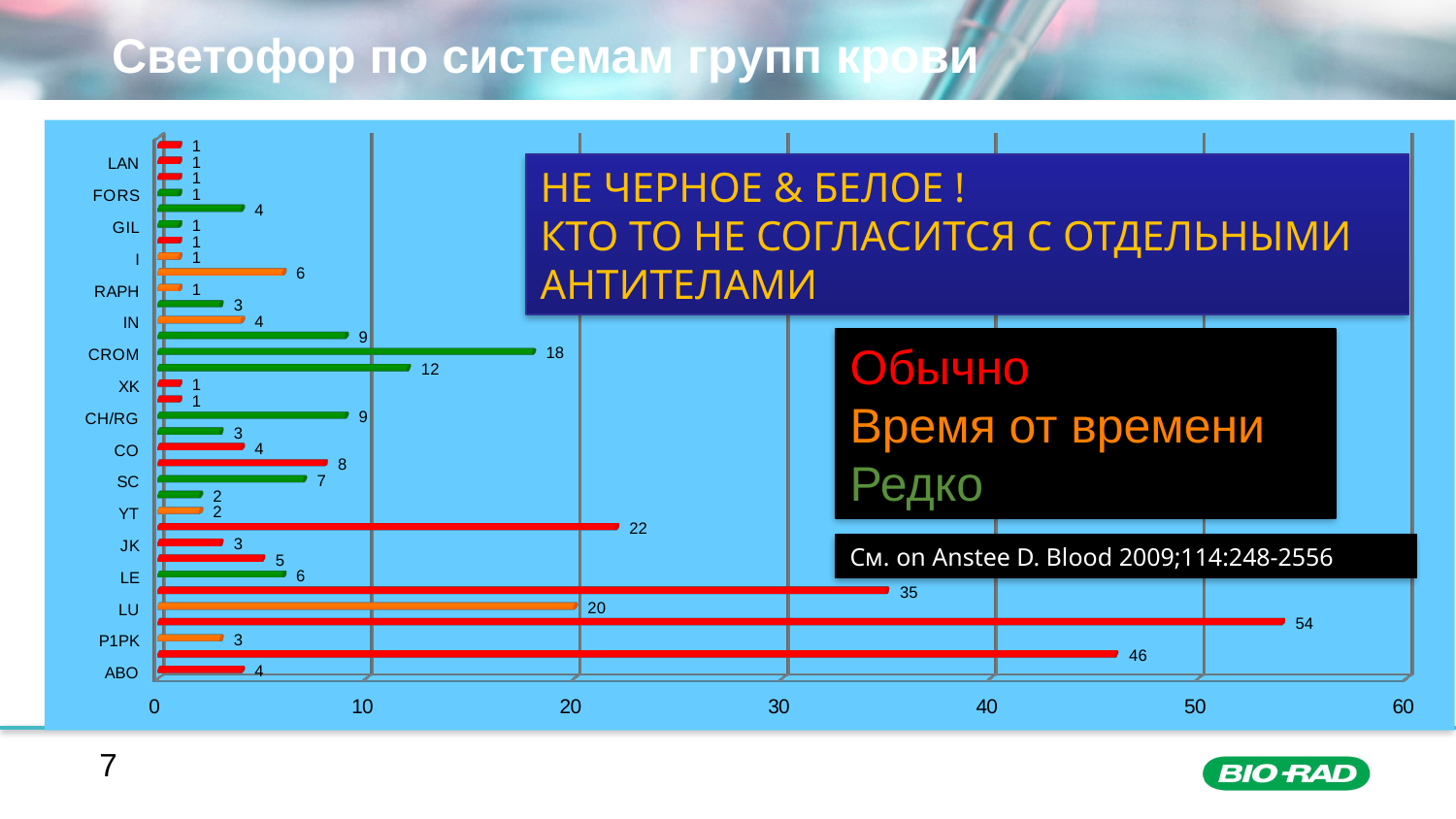
What is the value of the bar labelled for CROM? 18 What is the value of the bar labelled for LU? 20 What kind of chart is shown on the slide? bar chart What is the value of the bar labelled for CH/RG? 9 Which is larger, the bar with value 54 or the bar with value 46? 54 Is the bar labelled 46 greater or less than 40 on the x axis? greater What is the difference between the two longest bars, labelled 54 and 46? 8 What is the largest value labelled on any bar in the chart? 54 What is the maximum value shown on the x axis? 60 What is the value of the bar labelled for SC? 7 What is the title of the slide containing the chart? Светофор по системам групп крови What is the value of the bar labelled for LE? 6